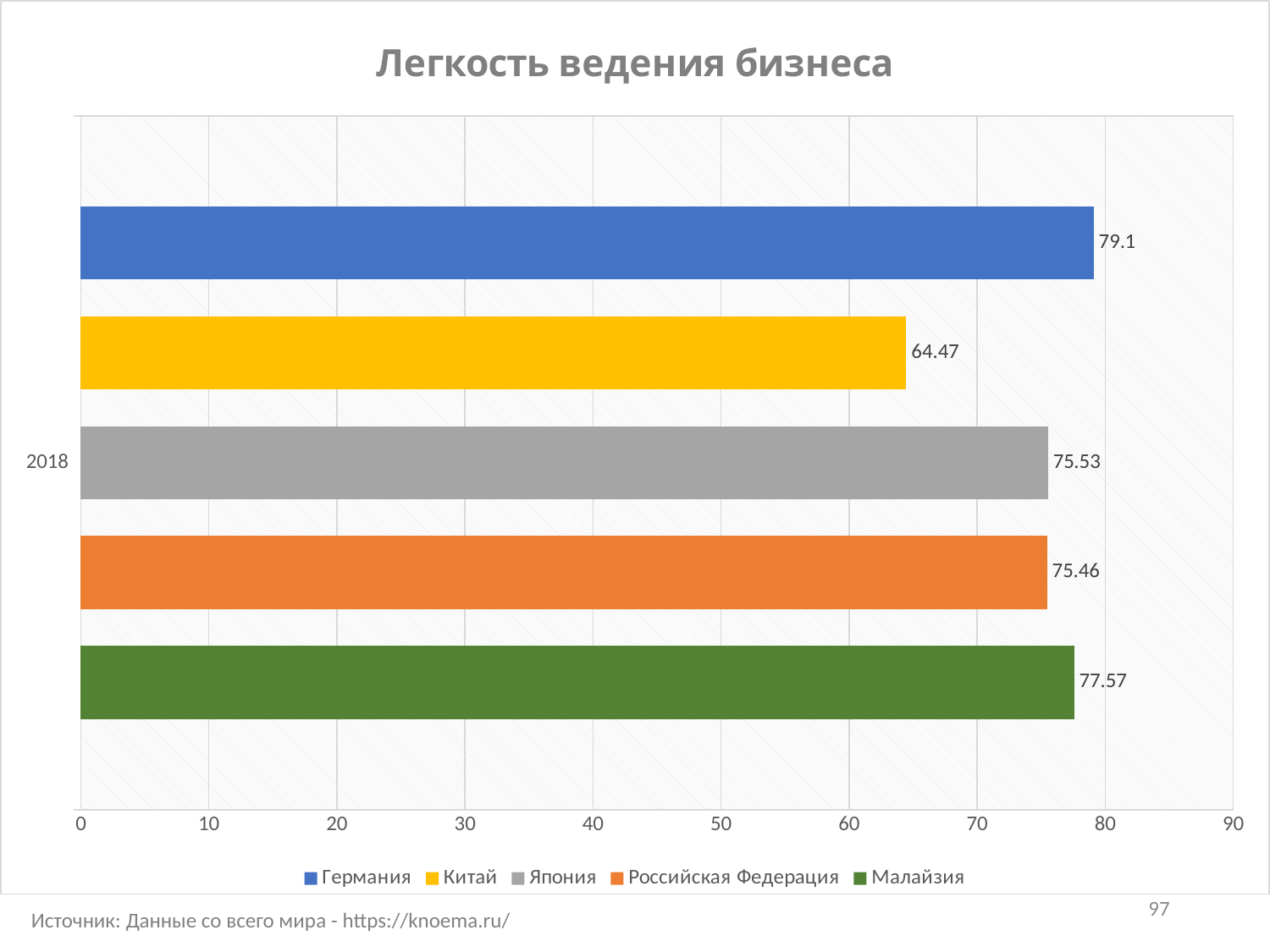
What is the value for Малайзия in 2018? 77.57 What is the value for Германия in 2018? 79.1 Which country has the lowest value in 2018? Китай Which is larger, the value for Малайзия or the value for Япония? Малайзия What is the title of the chart? Легкость ведения бизнеса What is the value for Китай in 2018? 64.47 What type of chart is shown on the slide? bar chart Is the value for Китай greater or less than 70? less How many series does the legend list? 5 What is the value for Российская Федерация in 2018? 75.46 What is the difference between the values for Германия and Китай? 14.63 Which country has the highest value in 2018? Германия